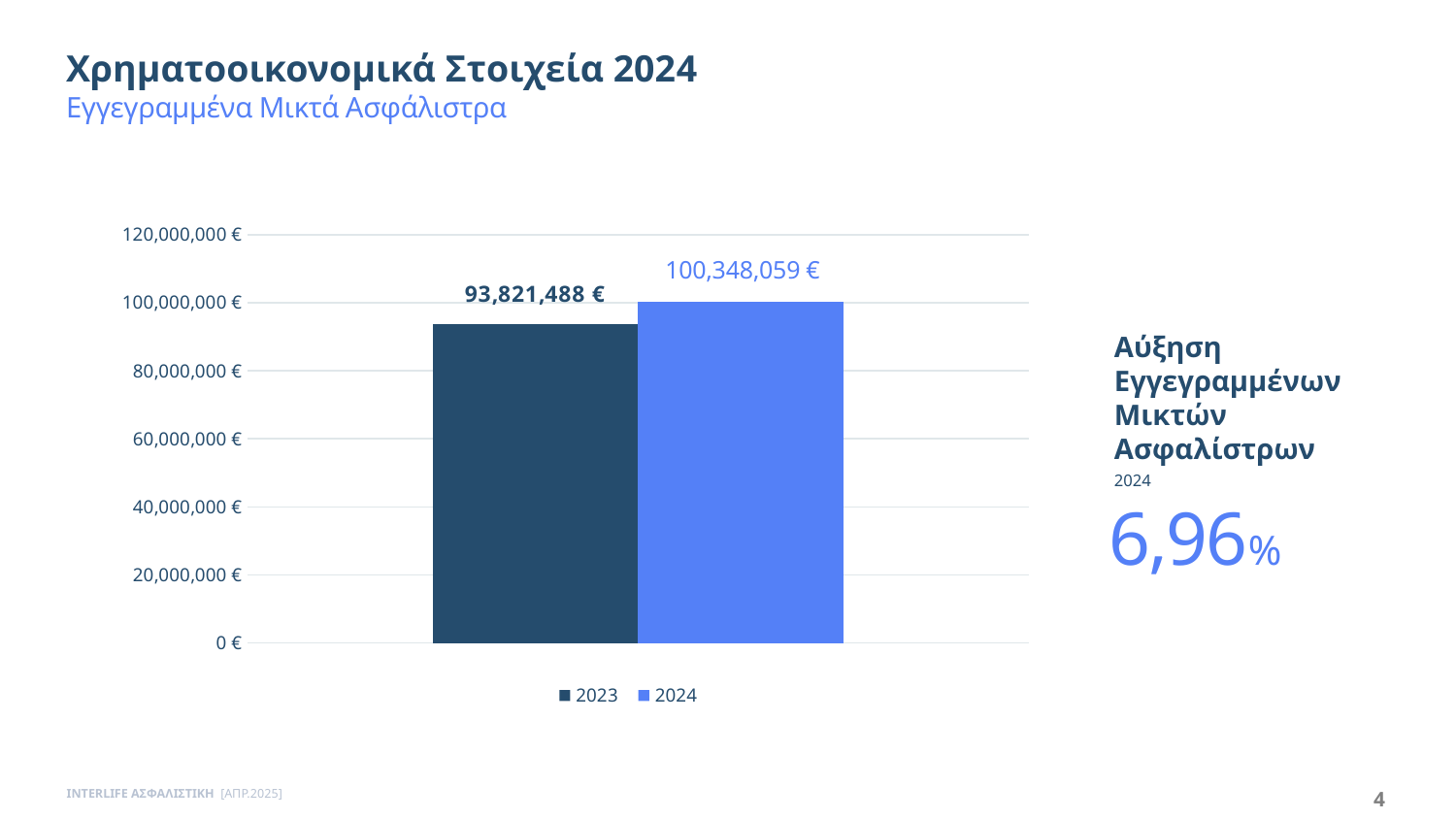
What is the value shown for 2023? 93,821,488 € What is the value shown for 2024? 100,348,059 € How many series does the legend list? 2 Which year has the higher value, 2023 or 2024? 2024 Which year has the lowest value on the chart? 2023 Is the value for 2024 greater or less than 100,000,000 €? greater Do the values rise or fall from 2023 to 2024? rise Is the value for 2023 greater or less than 100,000,000 €? less What is the difference between the 2024 value and the 2023 value? 6,526,571 € What percentage increase is stated on the slide next to the chart? 6,96% Which year has the highest value on the chart? 2024 What kind of chart is shown on the slide? bar chart